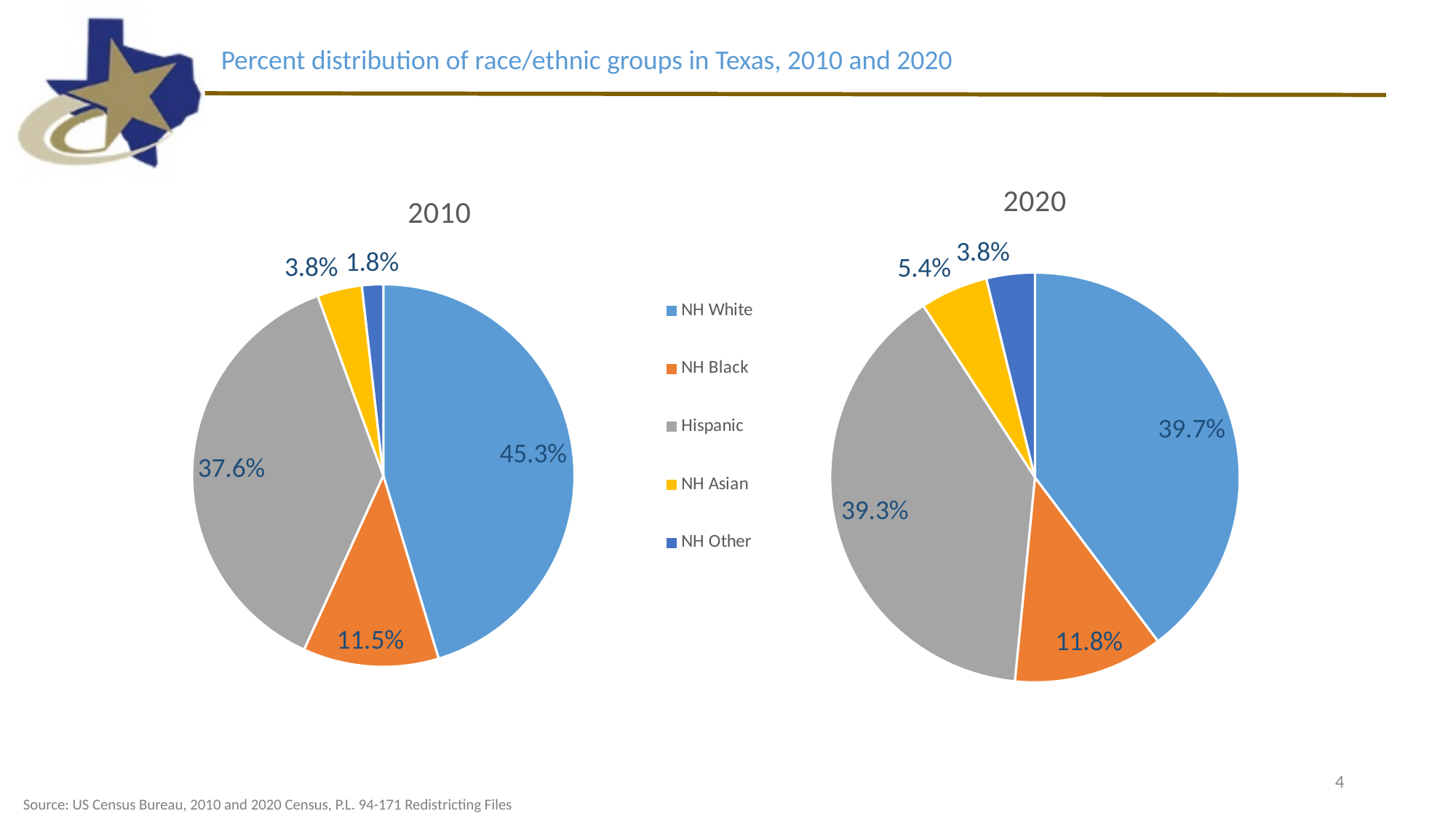
What is the difference between the NH White share in 2010 and in 2020? 5.6% In the 2010 pie chart, which group has the largest share? NH White In the 2010 pie chart, what is the share for NH White? 45.3% In the 2020 pie chart, what is the share for Hispanic? 39.3% What kind of chart is used to show the 2010 distribution? Pie chart In the 2010 pie chart, which group has the smallest share? NH Other In the 2010 pie chart, what is the share for NH Black? 11.5% In the 2020 pie chart, which group has the smallest share? NH Other In the 2010 pie chart, which is larger, the Hispanic share or the NH Black share? Hispanic Which colour represents NH Asian in the legend? Yellow How many slices does the 2020 pie chart have? 5 In the 2020 pie chart, what is the share for NH Asian? 5.4%